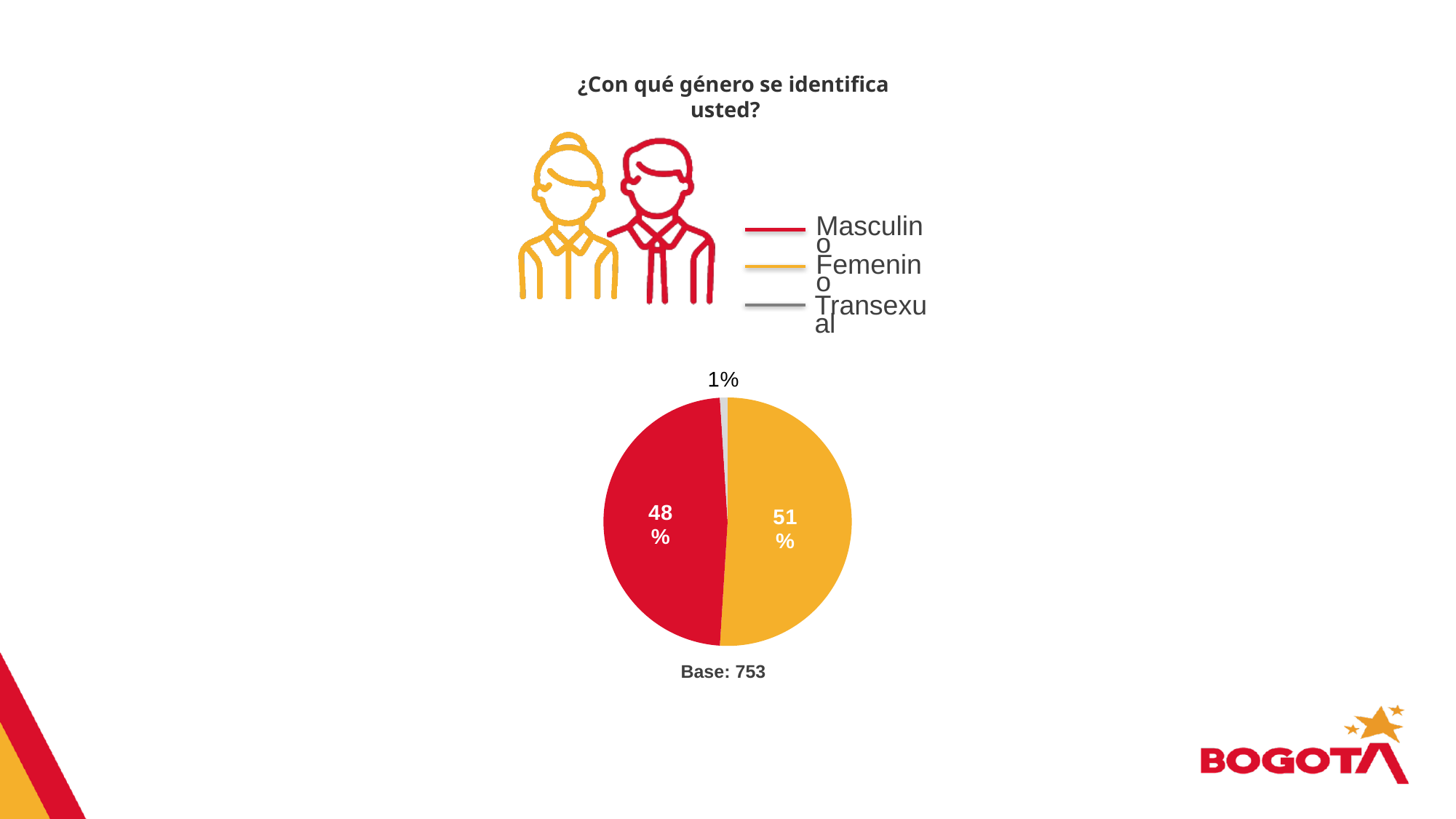
What is the difference in percentage points between Masculino and Transexual? 47 Which gender category has the smallest share of the pie? Transexual How many categories does the legend list? 3 What is the base (number of respondents) shown below the chart? 753 What percentage of respondents identified as Transexual? 1% What percentage of respondents identified as Femenino? 51% Which is larger, the share for Masculino or the share for Transexual? Masculino What is the difference in percentage points between Femenino and Masculino? 3 What kind of chart is shown on the slide? Pie chart What is the title of the chart? ¿Con qué género se identifica usted? What percentage of respondents identified as Masculino? 48% Which gender category has the largest share of the pie? Femenino